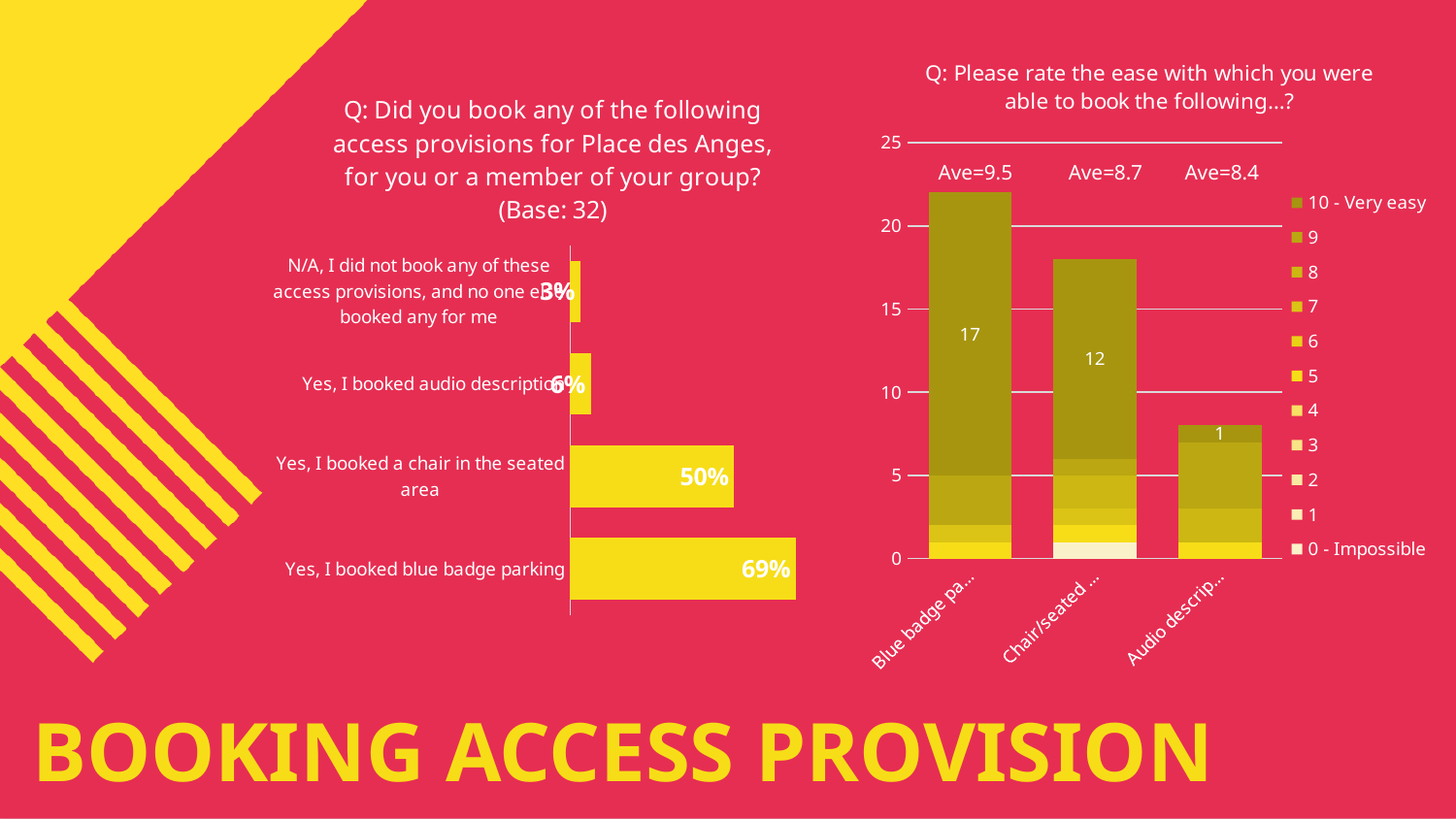
In the left chart, what percentage of respondents booked audio description? 6% In the left chart, what percentage of respondents booked blue badge parking? 69% In the right chart, how many respondents rated booking Chair/seated as '10 - Very easy'? 12 In the left chart, which access provision has the highest percentage? Yes, I booked blue badge parking In the left chart, what is the difference in percentage points between booking blue badge parking and booking a chair in the seated area? 19 What kind of chart is the left chart? Bar chart In the right chart, how many entries does the legend list? 11 In the left chart, how many categories are shown? 4 In the right chart, what is the average ease rating shown for Audio description? Ave=8.4 In the left chart, what percentage of respondents booked a chair in the seated area? 50% In the right chart, what is the average ease rating shown for Blue badge parking? Ave=9.5 In the right chart, is the total height of the Blue badge parking bar greater or less than 20? greater